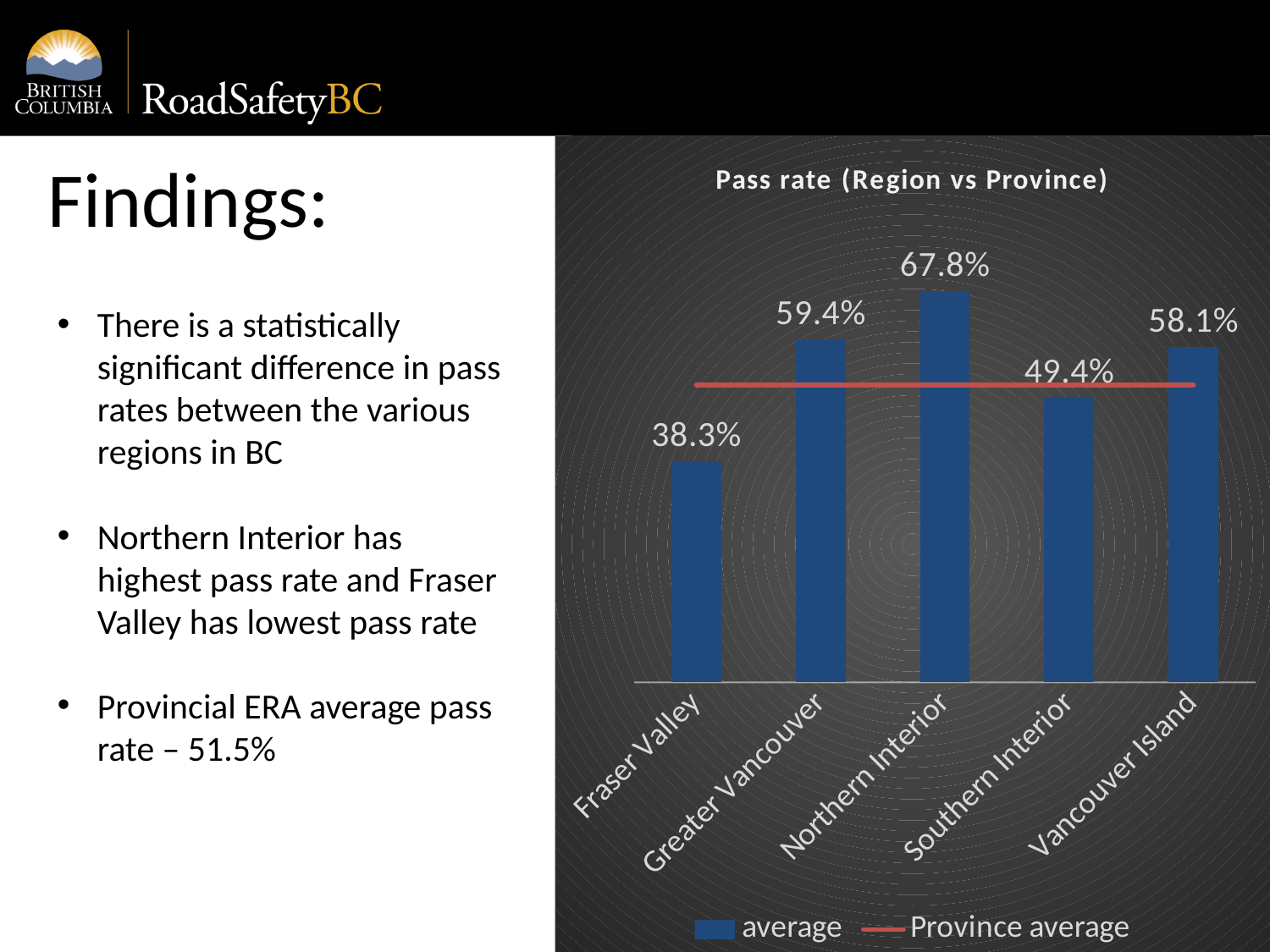
Which has a higher pass rate, Greater Vancouver or Vancouver Island? Greater Vancouver How many series does the legend list? 2 What is the title of the chart? Pass rate (Region vs Province) What is the pass rate for Northern Interior? 67.8% What is the pass rate for Southern Interior? 49.4% What is the difference in pass rate between Greater Vancouver and Southern Interior? 10.0 percentage points How many regions are shown on the chart? 5 What is the pass rate for Vancouver Island? 58.1% Which region has the lowest pass rate? Fraser Valley What is the difference in pass rate between Northern Interior and Fraser Valley? 29.5 percentage points What is the pass rate for Fraser Valley? 38.3% Which region has the highest pass rate? Northern Interior